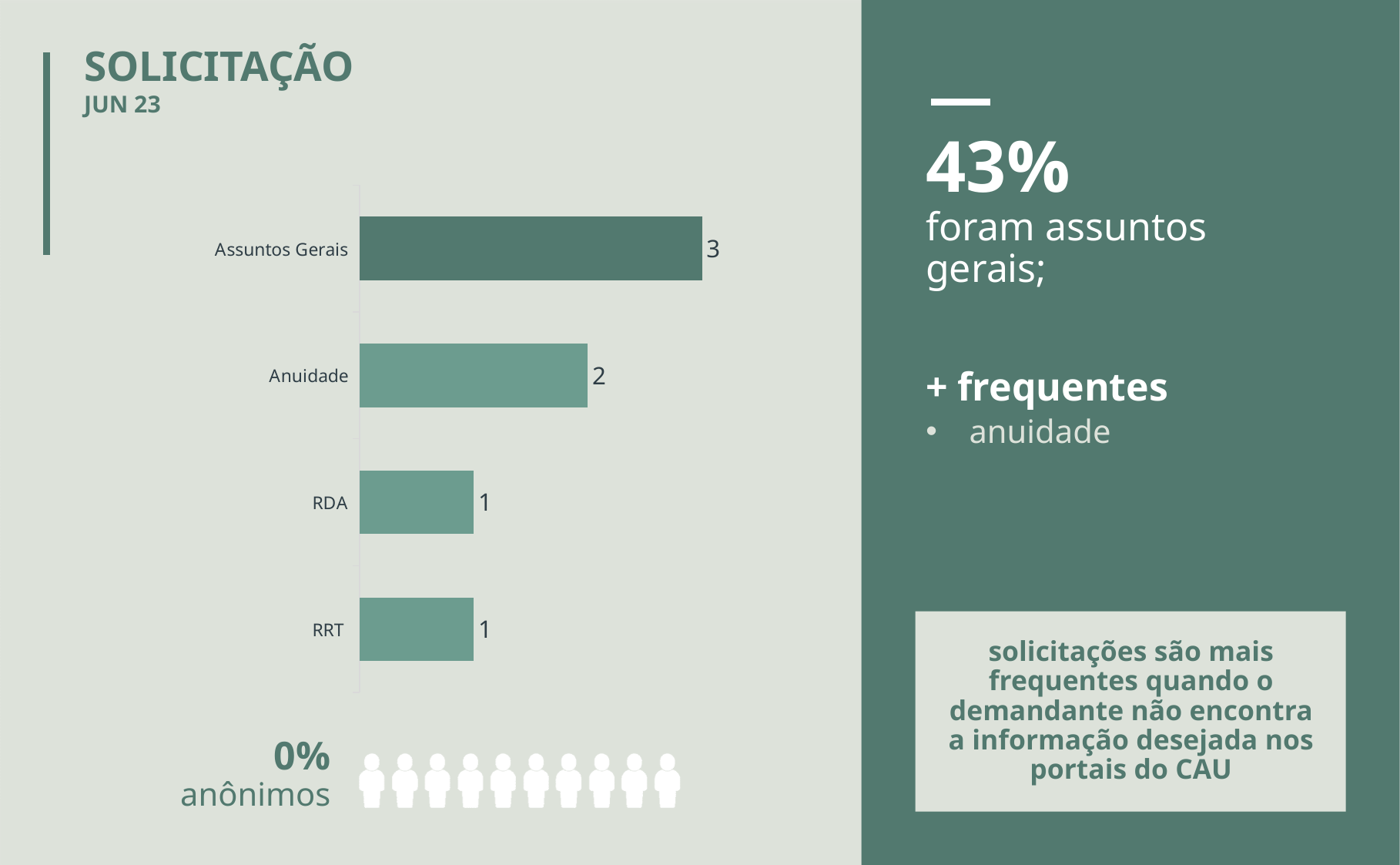
What is the total of all the values shown in the chart? 7 What kind of chart is shown on the slide? Bar chart Which month and year does the chart refer to? JUN 23 Which is larger, the value for Anuidade or the value for RDA? Anuidade What is the title of the chart? SOLICITAÇÃO How many categories are shown in the chart? 4 What is the value for RDA? 1 What is the value for Assuntos Gerais? 3 What is the difference between the values for Assuntos Gerais and Anuidade? 1 What is the value for RRT? 1 Which category has the highest value? Assuntos Gerais What is the value for Anuidade? 2